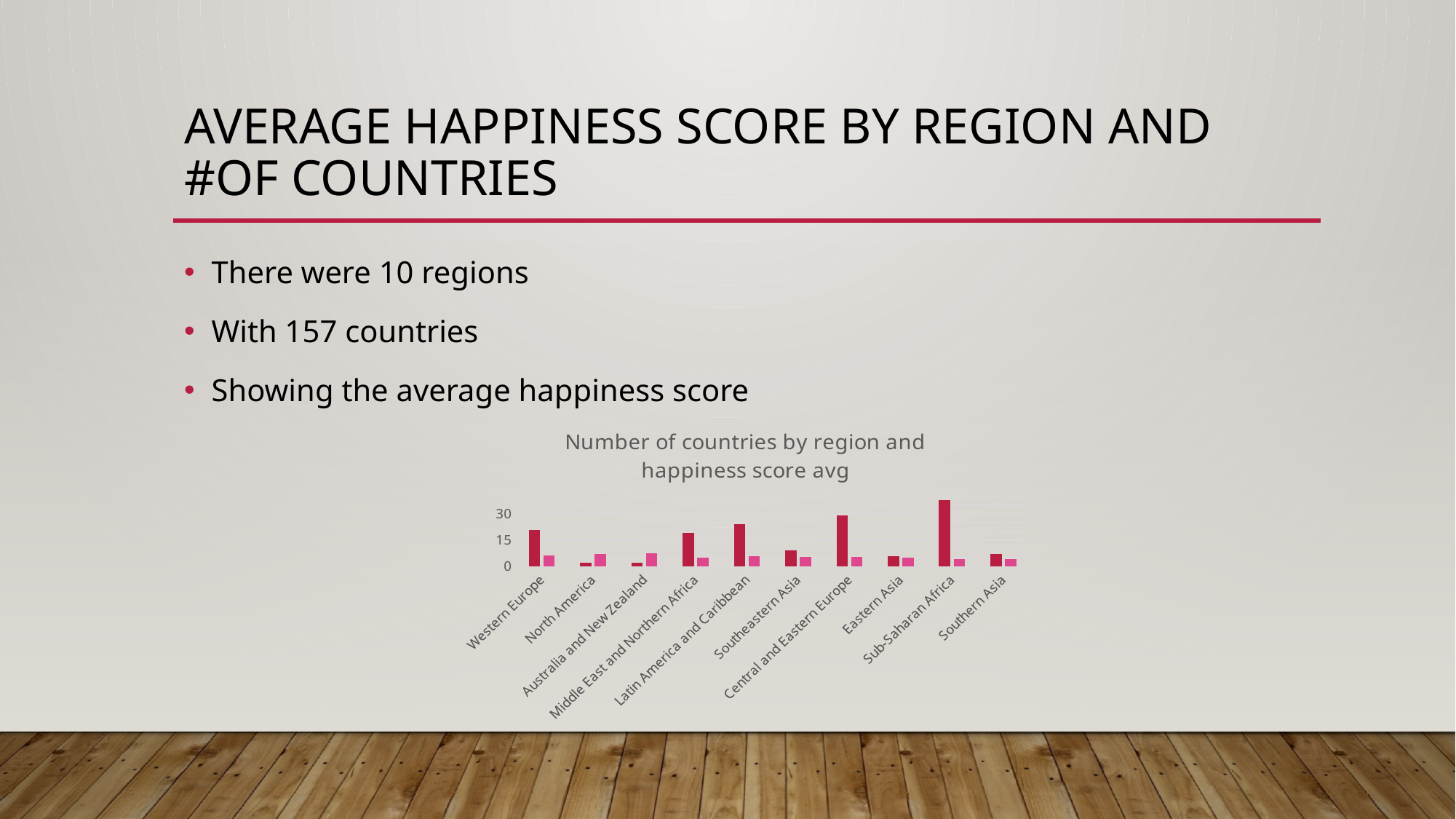
What is the title of the chart? Number of countries by region and happiness score avg Which region has the tallest dark red bar in the chart? Sub-Saharan Africa Which has the taller dark red bar, Sub-Saharan Africa or Western Europe? Sub-Saharan Africa Is the dark red bar for Western Europe greater or less than 15? greater Is the dark red bar for Latin America and Caribbean greater or less than 15? greater How many regions are shown on the x axis of the chart? 10 How many bars are plotted for each region in the chart? 2 What type of chart is shown on the slide? bar chart Is the dark red bar for Sub-Saharan Africa greater or less than 30? greater Which has the taller dark red bar, Latin America and Caribbean or Eastern Asia? Latin America and Caribbean